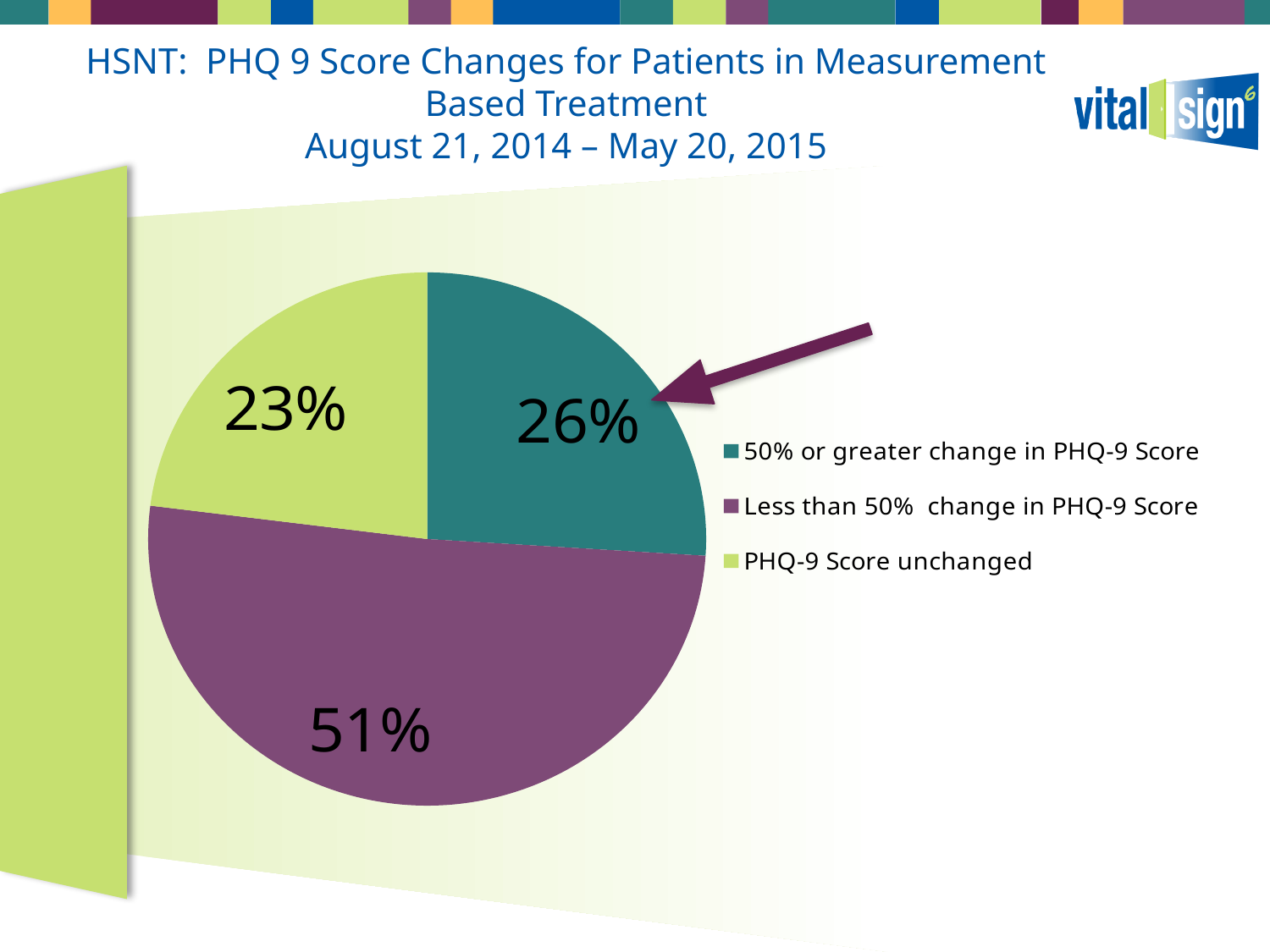
What kind of chart is shown on the slide? Pie chart What colour is the slice representing 'Less than 50% change in PHQ-9 Score'? Purple How many slices does the pie chart have? 3 What percentage of patients had less than 50% change in PHQ-9 Score? 51% How many entries does the legend list? 3 Which category has the largest share of the pie? Less than 50% change in PHQ-9 Score What is the difference in percentage points between the 'Less than 50% change in PHQ-9 Score' slice and the '50% or greater change in PHQ-9 Score' slice? 25 percentage points Which category has the smallest share of the pie? PHQ-9 Score unchanged What percentage of patients had their PHQ-9 Score unchanged? 23% Which is larger: the share for '50% or greater change in PHQ-9 Score' or the share for 'PHQ-9 Score unchanged'? 50% or greater change in PHQ-9 Score What percentage of patients had a 50% or greater change in PHQ-9 Score? 26% Which slice does the arrow on the slide point to? 50% or greater change in PHQ-9 Score (26%)